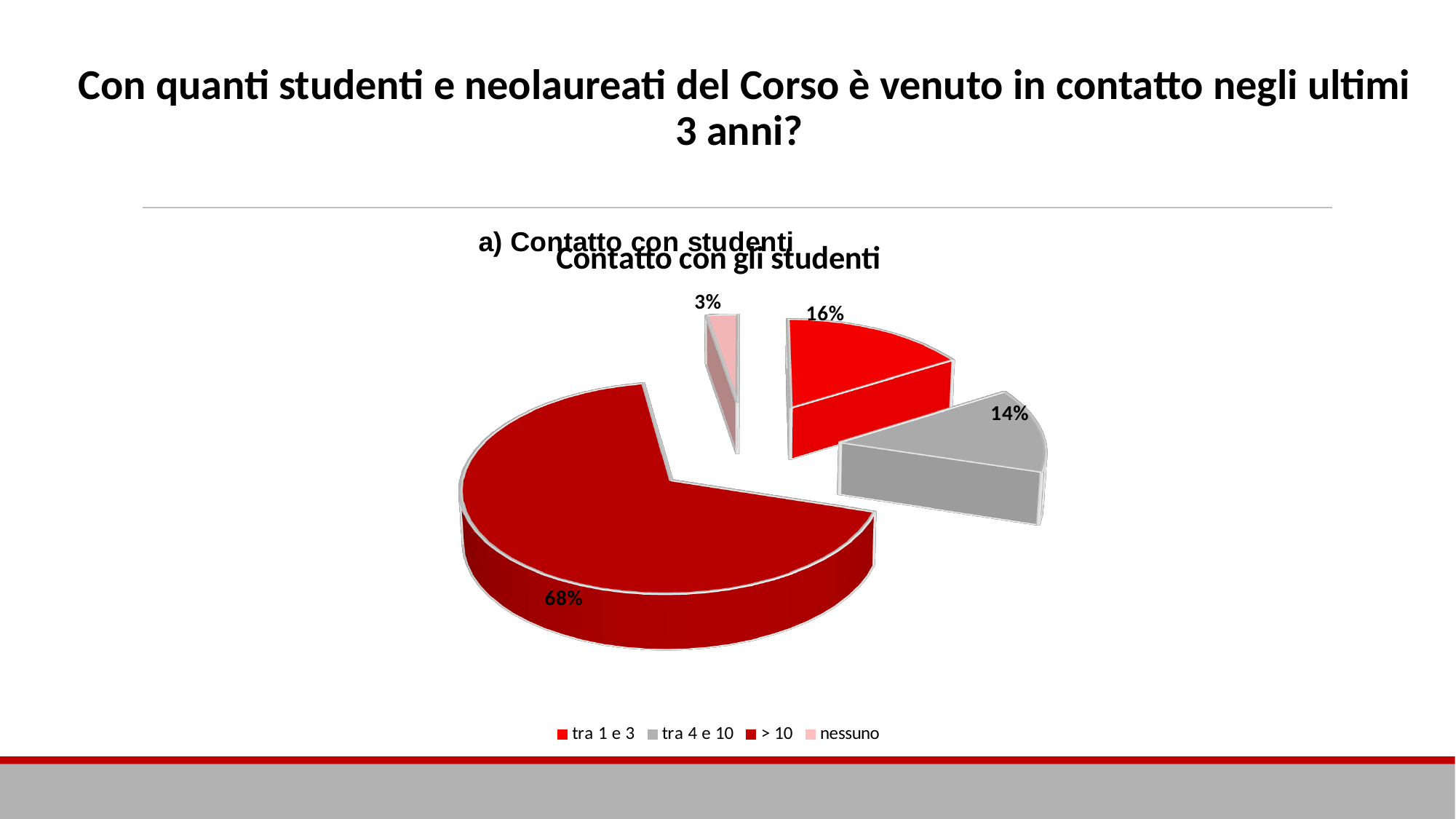
Which category has the smallest slice of the pie? nessuno Which category has the largest slice of the pie? > 10 What share of the pie does the "tra 1 e 3" slice represent? 16% What is the title of the pie chart? Contatto con gli studenti What share of the pie does the "tra 4 e 10" slice represent? 14% What kind of chart is shown on the slide? pie chart What share of the pie does the "nessuno" slice represent? 3% How many entries does the legend list? 4 What is the difference in percentage points between the "> 10" slice and the "tra 1 e 3" slice? 52 Which slice is larger, "tra 1 e 3" or "tra 4 e 10"? tra 1 e 3 What share of the pie does the "> 10" slice represent? 68% How many slices does the pie chart have? 4